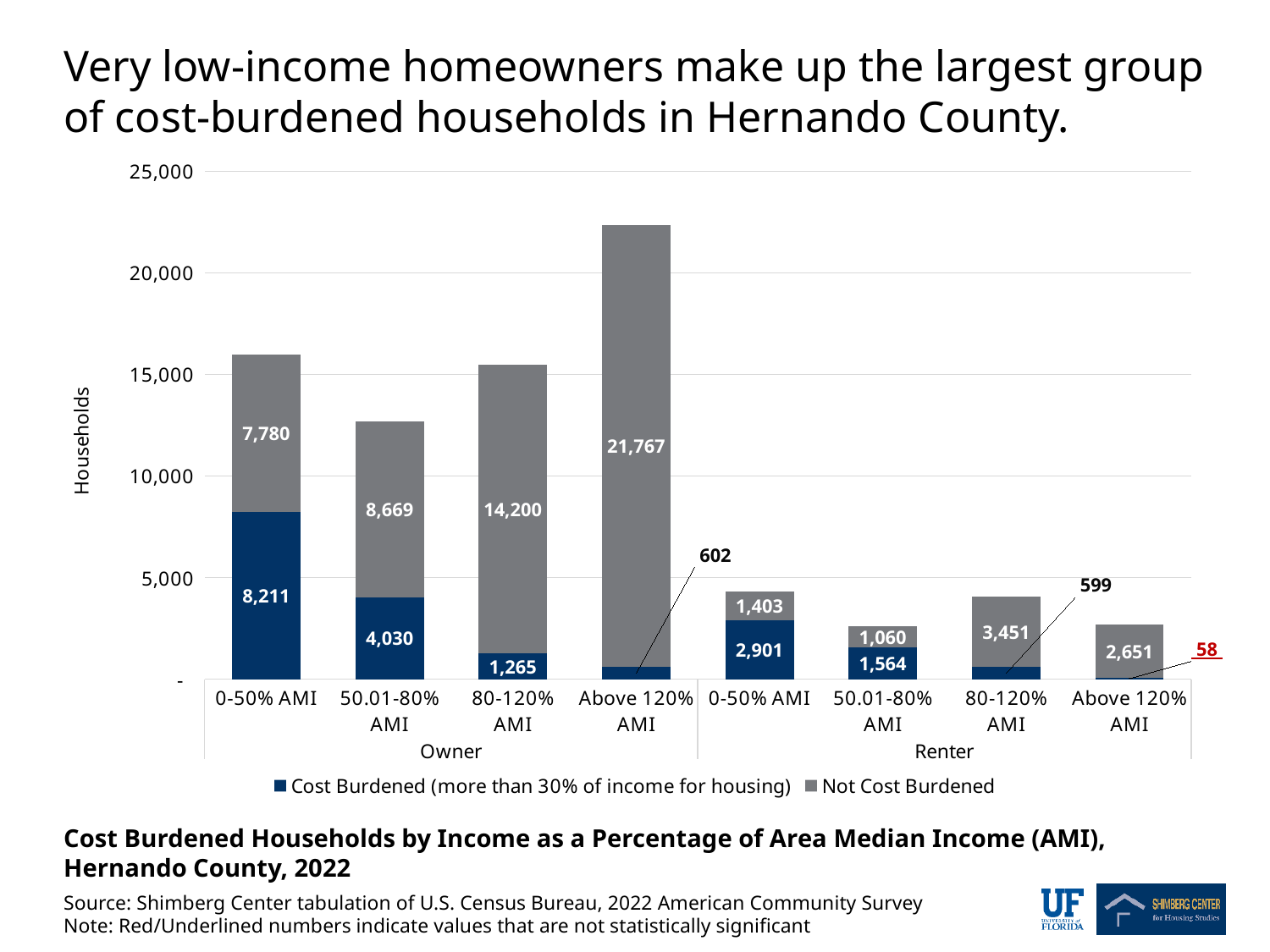
Which category has the largest number of cost-burdened households? Owner 0-50% AMI What is the total number of households (cost burdened plus not cost burdened) for owners in the 50.01-80% AMI category? 12,699 What is the Cost Burdened value for renters in the 50.01-80% AMI category? 1,564 Which category has the smallest number of cost-burdened households? Renter Above 120% AMI How many series does the legend list? 2 What is the Not Cost Burdened value for owners above 120% AMI? 21,767 Which value on the chart is shown in red and underlined to indicate it is not statistically significant? 58 What kind of chart is shown on the slide? Stacked bar chart How many income categories are plotted across the Owner and Renter groups combined? 8 What is the difference between the cost-burdened owner households at 0-50% AMI and at 50.01-80% AMI? 4,181 How many cost-burdened owner households are in the 0-50% AMI category? 8,211 Which is larger: the Not Cost Burdened value for owners at 80-120% AMI or for owners at 50.01-80% AMI? Owners at 80-120% AMI